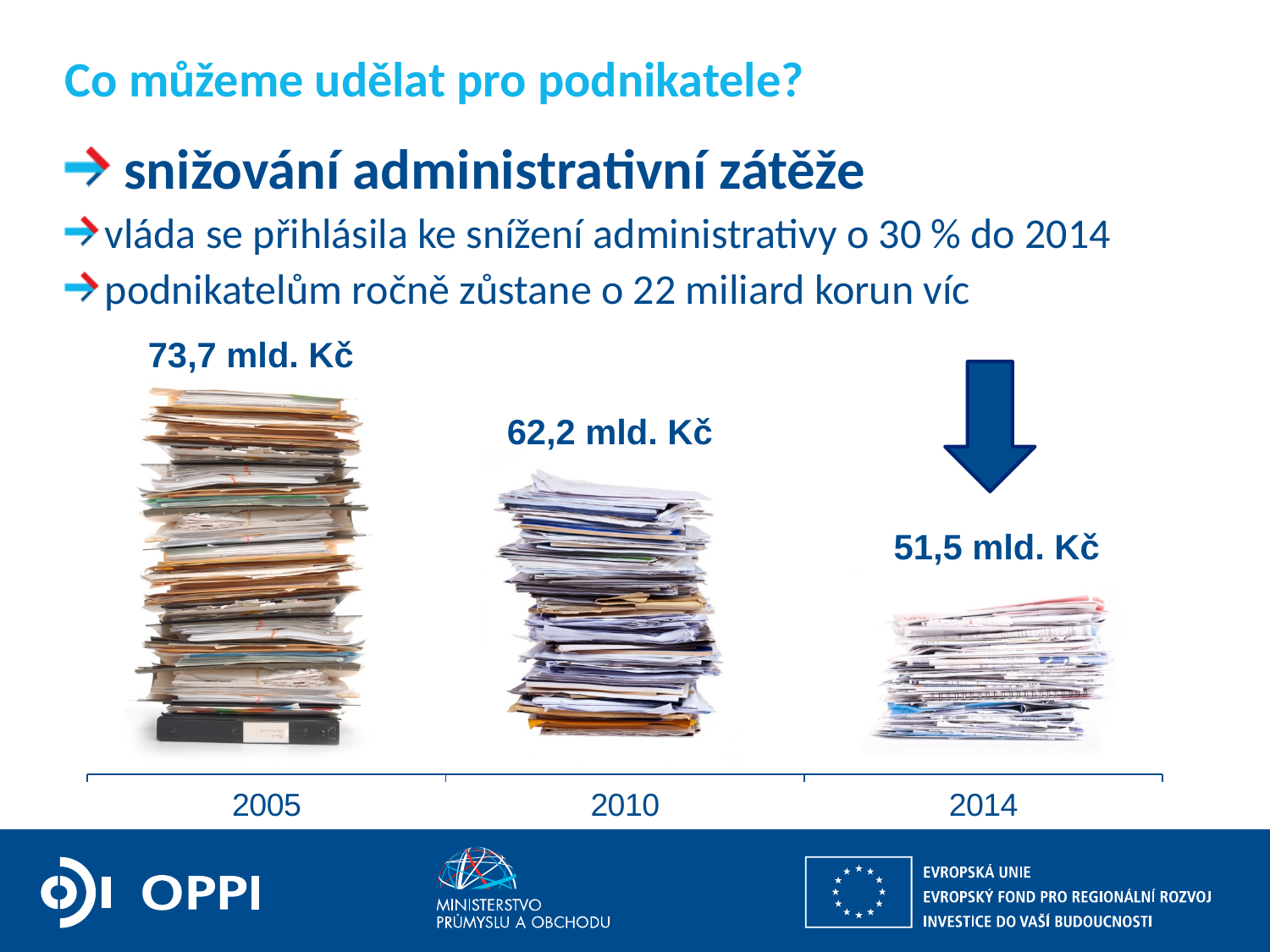
Which year has the lowest value? 2014 What value is shown for 2010? 62,2 mld. Kč Do the values rise or fall from 2005 to 2014? fall What is the difference between the values for 2005 and 2014? 22,2 mld. Kč Which is larger, the value for 2010 or the value for 2014? 2010 What value is shown for 2014? 51,5 mld. Kč What is the difference between the values for 2010 and 2014? 10,7 mld. Kč What value is shown for 2005? 73,7 mld. Kč Which year has the highest value? 2005 What is the difference between the values for 2005 and 2010? 11,5 mld. Kč How many years are shown on the timeline? 3 What unit are the values given in? mld. Kč